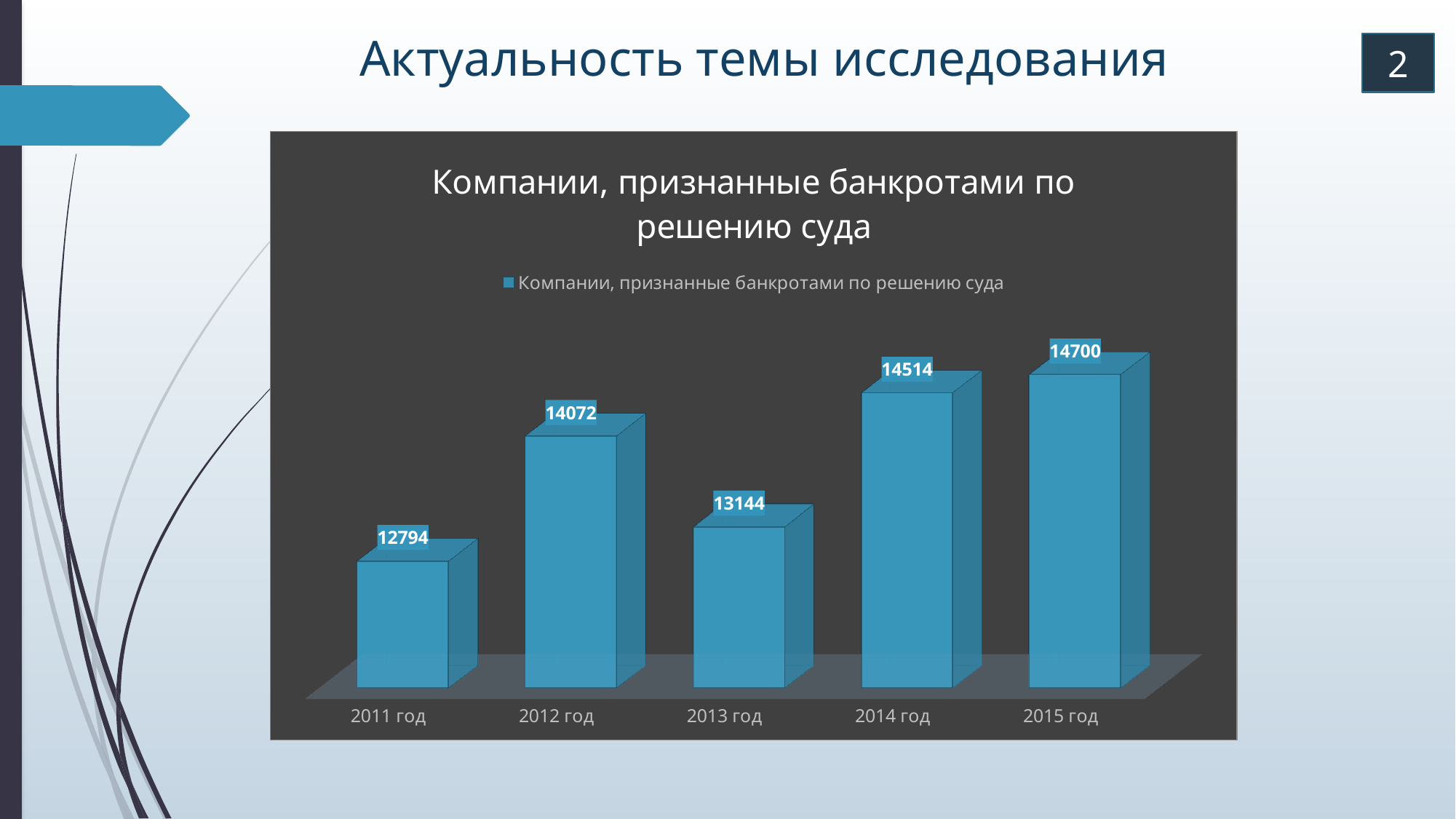
What is the difference between the values for 2014 год and 2013 год? 1370 What is the value for 2011 год? 12794 What is the value for 2015 год? 14700 What is the difference between the values for 2015 год and 2011 год? 1906 What is the title of the chart? Компании, признанные банкротами по решению суда What is the value for 2013 год? 13144 What kind of chart is shown on the slide? bar chart How many series does the legend list? 1 How many years are shown on the x axis? 5 Which is larger, the value for 2012 год or the value for 2013 год? 2012 год Which year has the highest value? 2015 год Which year has the lowest value? 2011 год